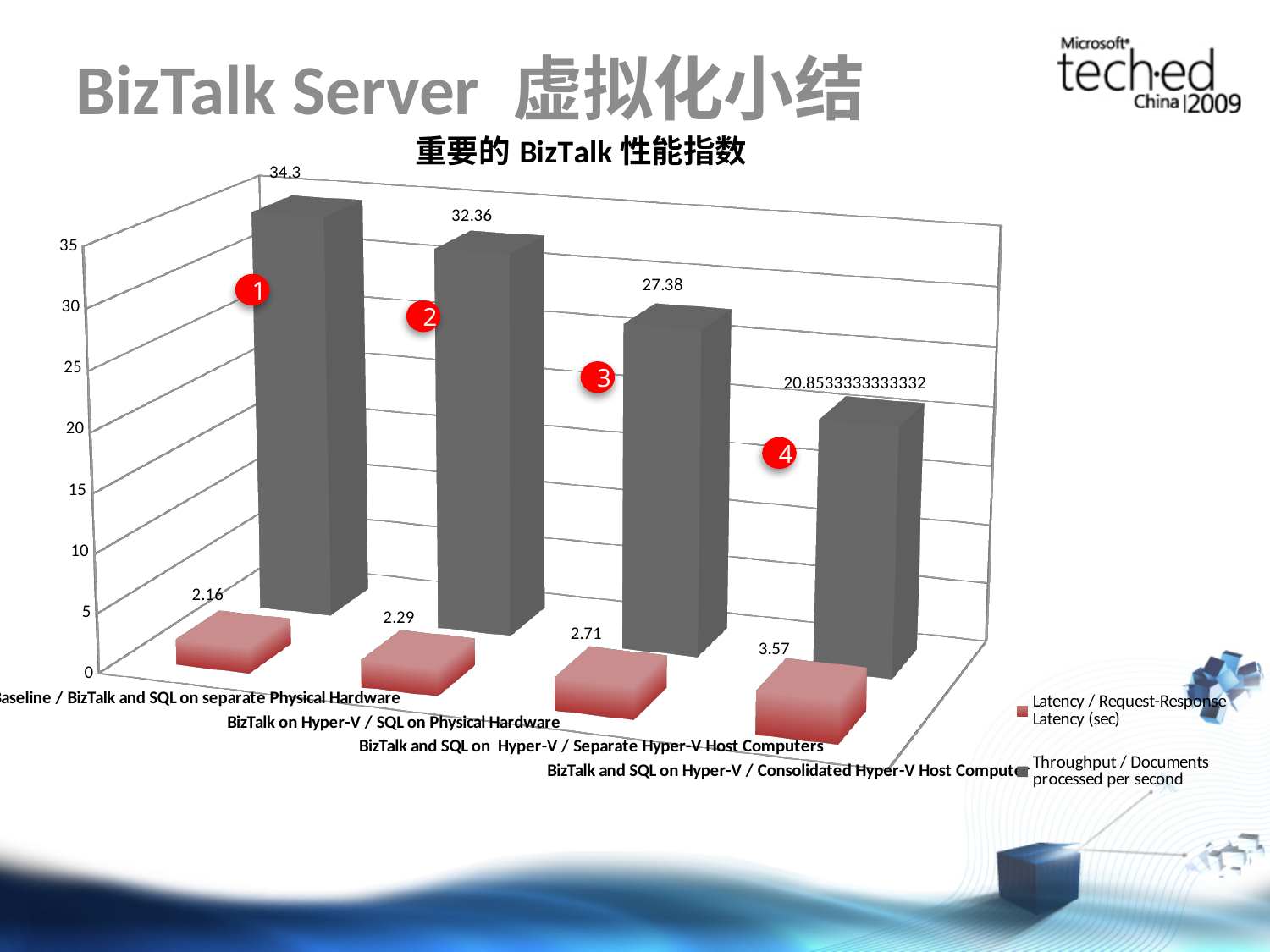
What is the Throughput value for the Baseline / BizTalk and SQL on separate Physical Hardware configuration? 34.3 Does the Throughput / Documents processed per second series rise or fall from left to right across the configurations? Fall What is the Latency / Request-Response Latency (sec) value for "BizTalk and SQL on Hyper-V / Separate Hyper-V Host Computers"? 2.71 How many series does the chart legend list? 2 How many configurations (categories) are shown on the x axis of the chart? 4 What is the difference in Throughput between "BizTalk on Hyper-V / SQL on Physical Hardware" and "BizTalk and SQL on Hyper-V / Separate Hyper-V Host Computers"? 4.98 What is the title of the chart? 重要的 BizTalk 性能指数 Which configuration has the highest Latency / Request-Response Latency (sec)? BizTalk and SQL on Hyper-V / Consolidated Hyper-V Host Computer Which configuration has the lowest Throughput / Documents processed per second? BizTalk and SQL on Hyper-V / Consolidated Hyper-V Host Computer What kind of chart is shown on the slide? Bar chart Which is larger: the Latency for "BizTalk on Hyper-V / SQL on Physical Hardware" or the Latency for "BizTalk and SQL on Hyper-V / Separate Hyper-V Host Computers"? BizTalk and SQL on Hyper-V / Separate Hyper-V Host Computers What is the Throughput / Documents processed per second value for "BizTalk on Hyper-V / SQL on Physical Hardware"? 32.36